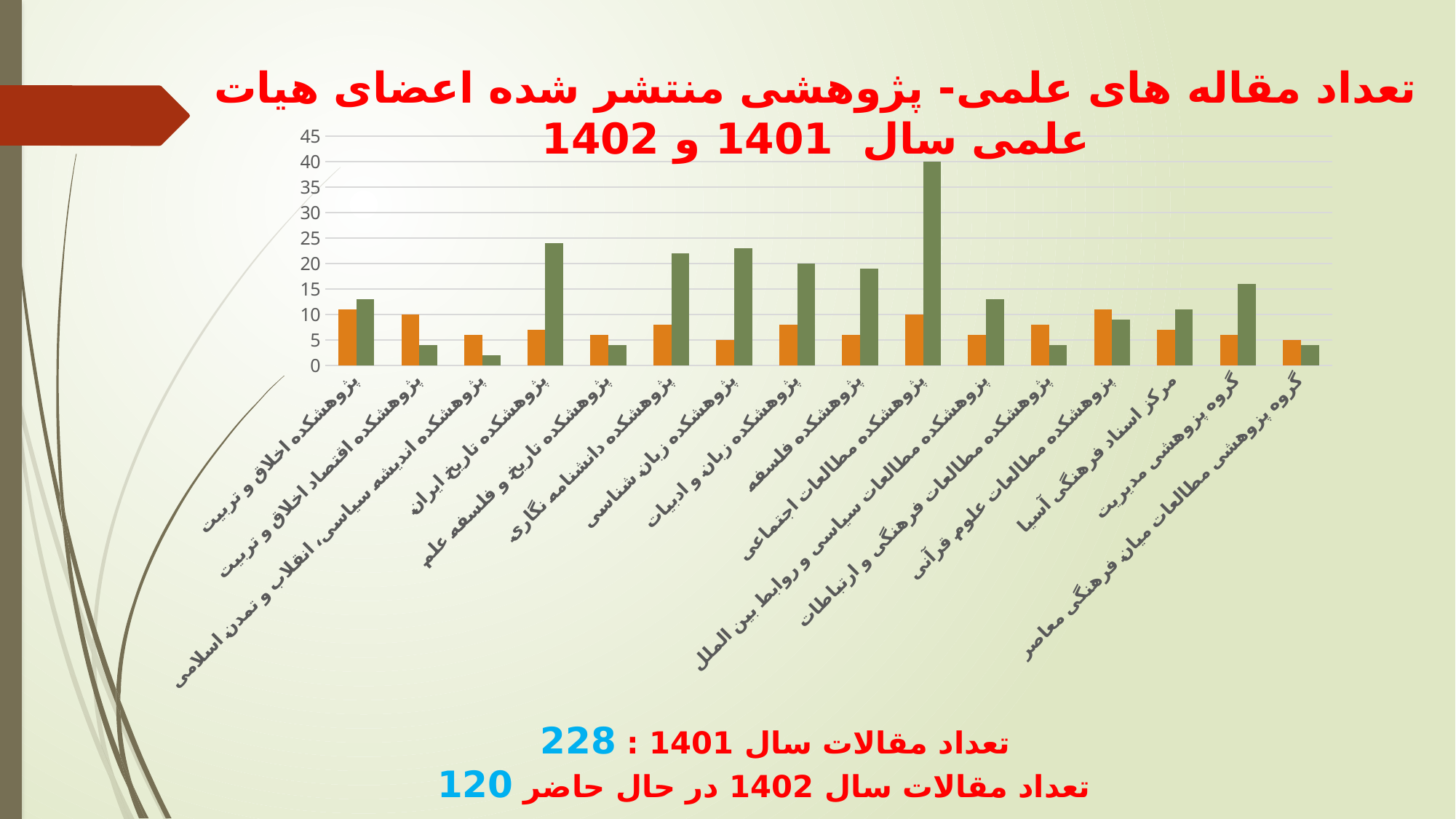
Which category has the tallest bar on the chart? پژوهشکده مطالعات اجتماعی Is the green bar for پژوهشکده اخلاق و تربیت greater or less than 10? greater Is the tallest bar on the chart greater or less than 35? greater What is the highest value reached by any bar on the chart? 40 For پژوهشکده مطالعات اجتماعی, which bar is taller, the orange one or the green one? green Is the orange bar for پژوهشکده مطالعات اجتماعی greater or less than 20? less How many bars are plotted for each category? 2 What is the highest tick value shown on the vertical axis? 45 According to the text below the chart, how many articles were published in 1401? 228 What kind of chart is shown on the slide? bar chart